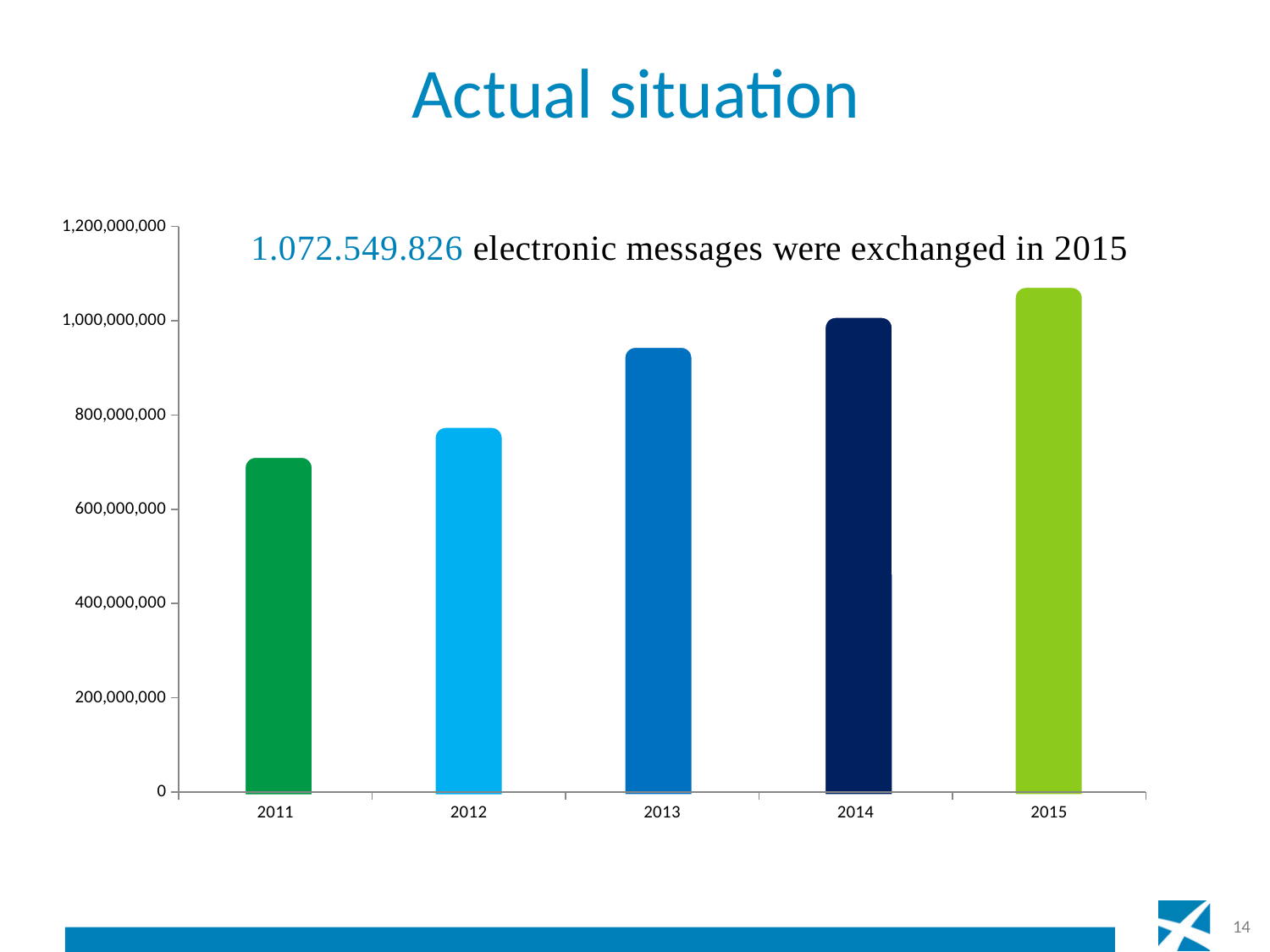
Is the value for 2011 greater or less than 800,000,000? less What is the title of the slide containing the chart? Actual situation Which year has the lowest bar in the chart? 2011 Is the value for 2013 greater or less than 800,000,000? greater Do the values rise or fall from 2011 to 2015? rise Which is larger, the value for 2012 or the value for 2013? 2013 How many years (categories) are shown on the x axis of the chart? 5 Which year has the highest bar in the chart? 2015 Is the value for 2012 greater or less than 600,000,000? greater What kind of chart is shown on the slide? bar chart According to the text on the chart, how many electronic messages were exchanged in 2015? 1.072.549.826